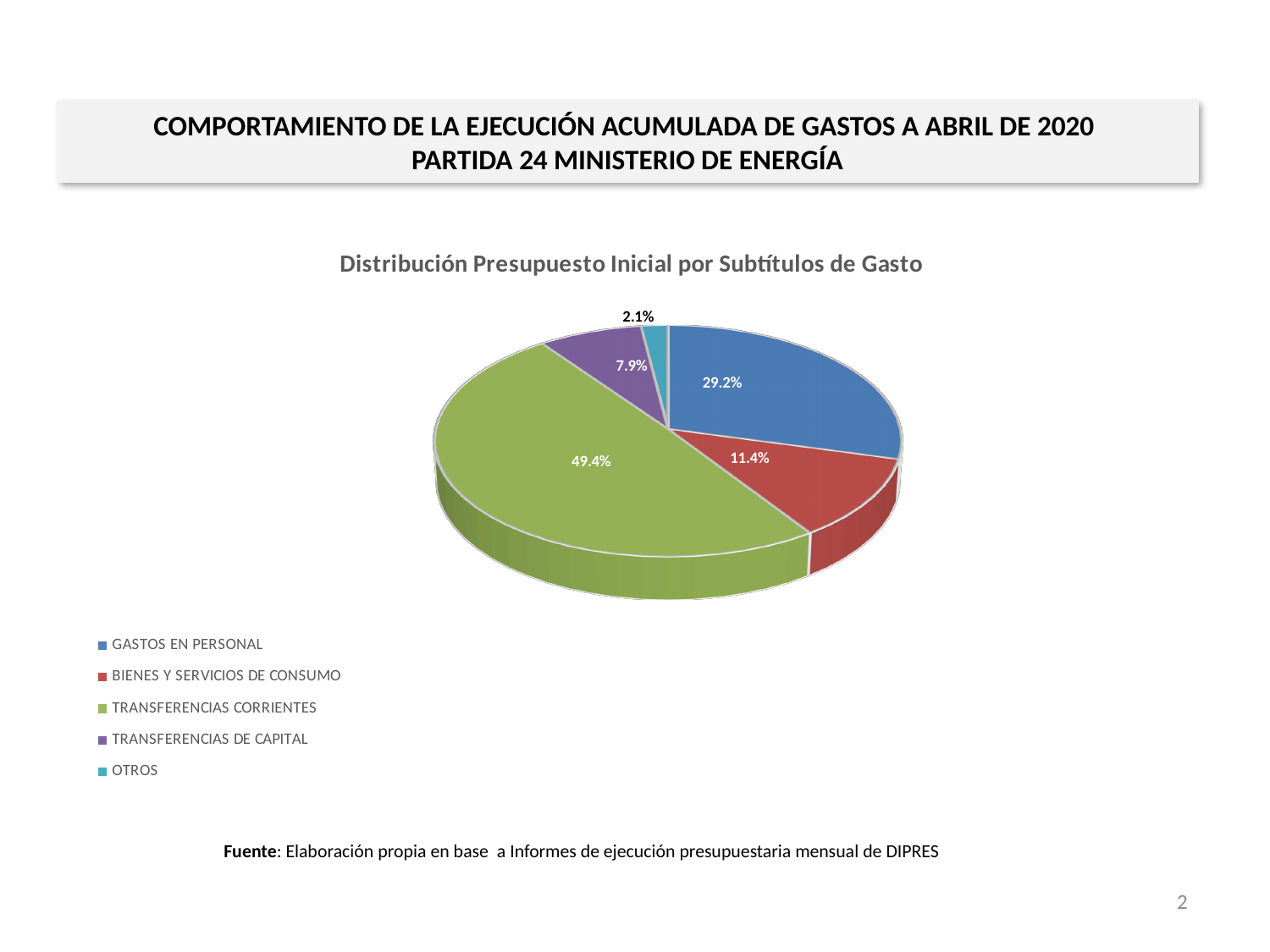
What is the title of the chart? Distribución Presupuesto Inicial por Subtítulos de Gasto What is the difference in percentage points between TRANSFERENCIAS CORRIENTES and GASTOS EN PERSONAL? 20.2 percentage points What share of the pie does TRANSFERENCIAS CORRIENTES represent? 49.4% Which is larger, the share for BIENES Y SERVICIOS DE CONSUMO or the share for TRANSFERENCIAS DE CAPITAL? BIENES Y SERVICIOS DE CONSUMO What is the value shown for OTROS? 2.1% Which category has the largest slice of the pie? TRANSFERENCIAS CORRIENTES What share of the pie does GASTOS EN PERSONAL represent? 29.2% Which category has the smallest slice of the pie? OTROS How many categories does the legend list? 5 What is the value shown for BIENES Y SERVICIOS DE CONSUMO? 11.4% What is the value shown for TRANSFERENCIAS DE CAPITAL? 7.9% What type of chart is shown on the slide? Pie chart